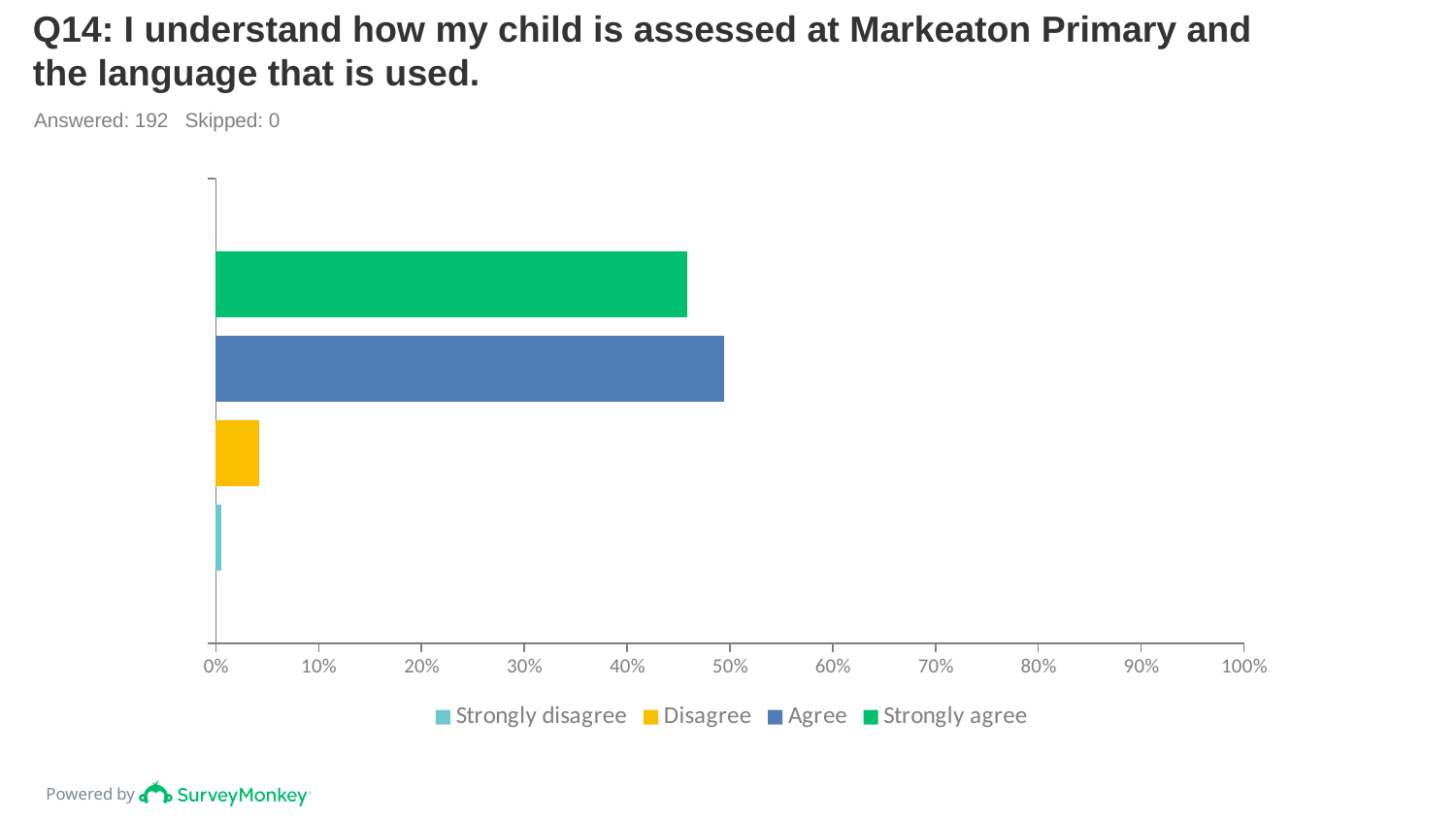
Which response option has the shortest bar? Strongly disagree How many respondents answered this question according to the slide? 192 How many bars are plotted in the chart? 4 Is the value for Strongly agree greater or less than 50%? less Which is larger, the value for Disagree or the value for Strongly disagree? Disagree Is the value for Agree greater or less than 60%? less How many series does the legend list? 4 What kind of chart is shown on the slide? Bar chart Which response option has the longest bar? Agree Is the value for Disagree greater or less than 10%? less Which is larger, the value for Strongly agree or the value for Disagree? Strongly agree